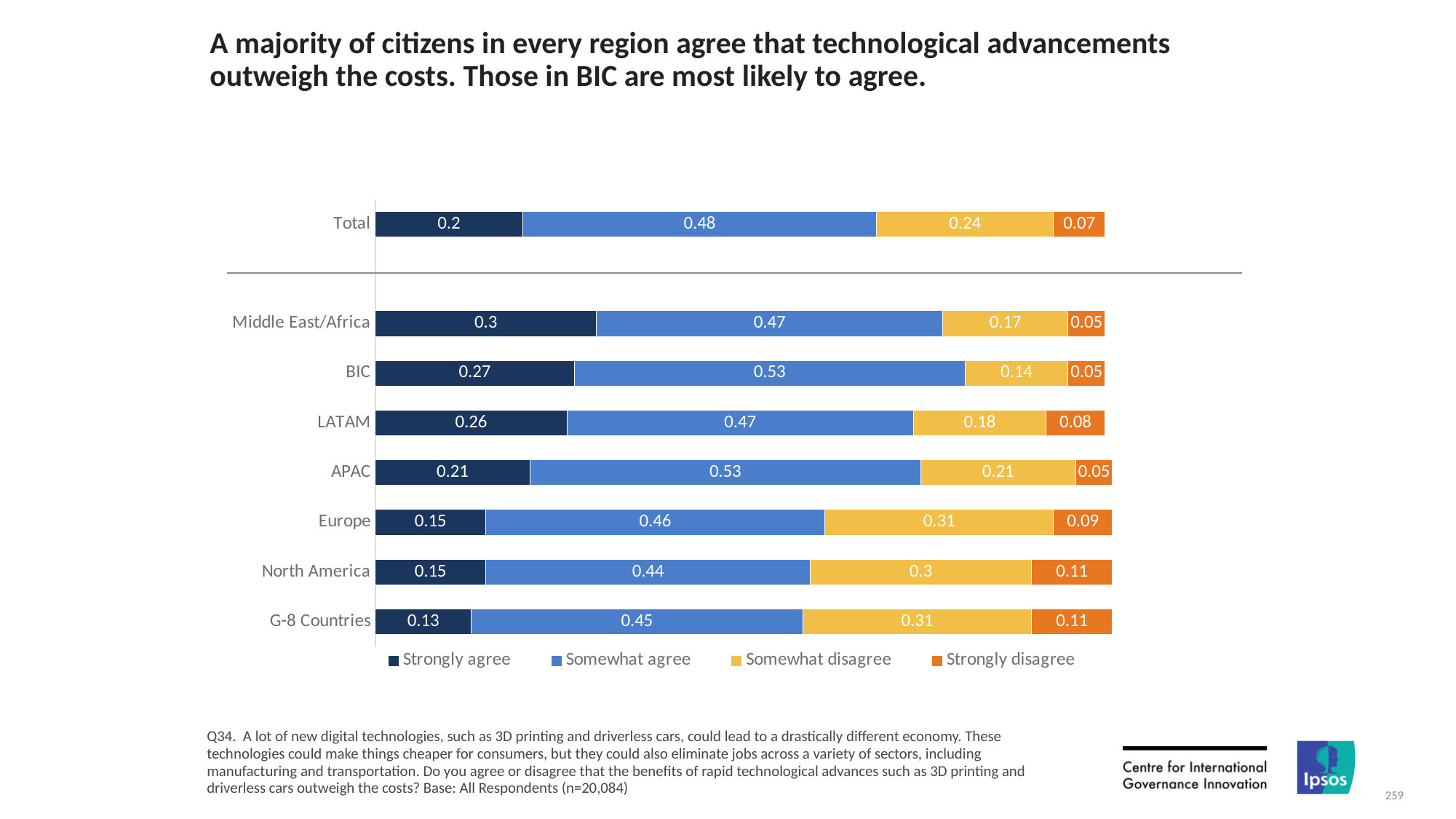
What is the Strongly agree value for Middle East/Africa? 0.3 Which has a larger Strongly agree value, LATAM or APAC? LATAM How many series does the legend list? 4 Which category has the lowest Somewhat disagree value? BIC What is the Strongly disagree value for North America? 0.11 What is the Somewhat agree value for BIC? 0.53 Which region has the highest Strongly agree value? Middle East/Africa What is the difference between the Somewhat disagree values for Europe and BIC? 0.17 What is the Somewhat disagree value for Total? 0.24 How many categories (bars) are shown in the chart? 8 Which category has the lowest Strongly agree value? G-8 Countries What kind of chart is shown on the slide? Stacked bar chart